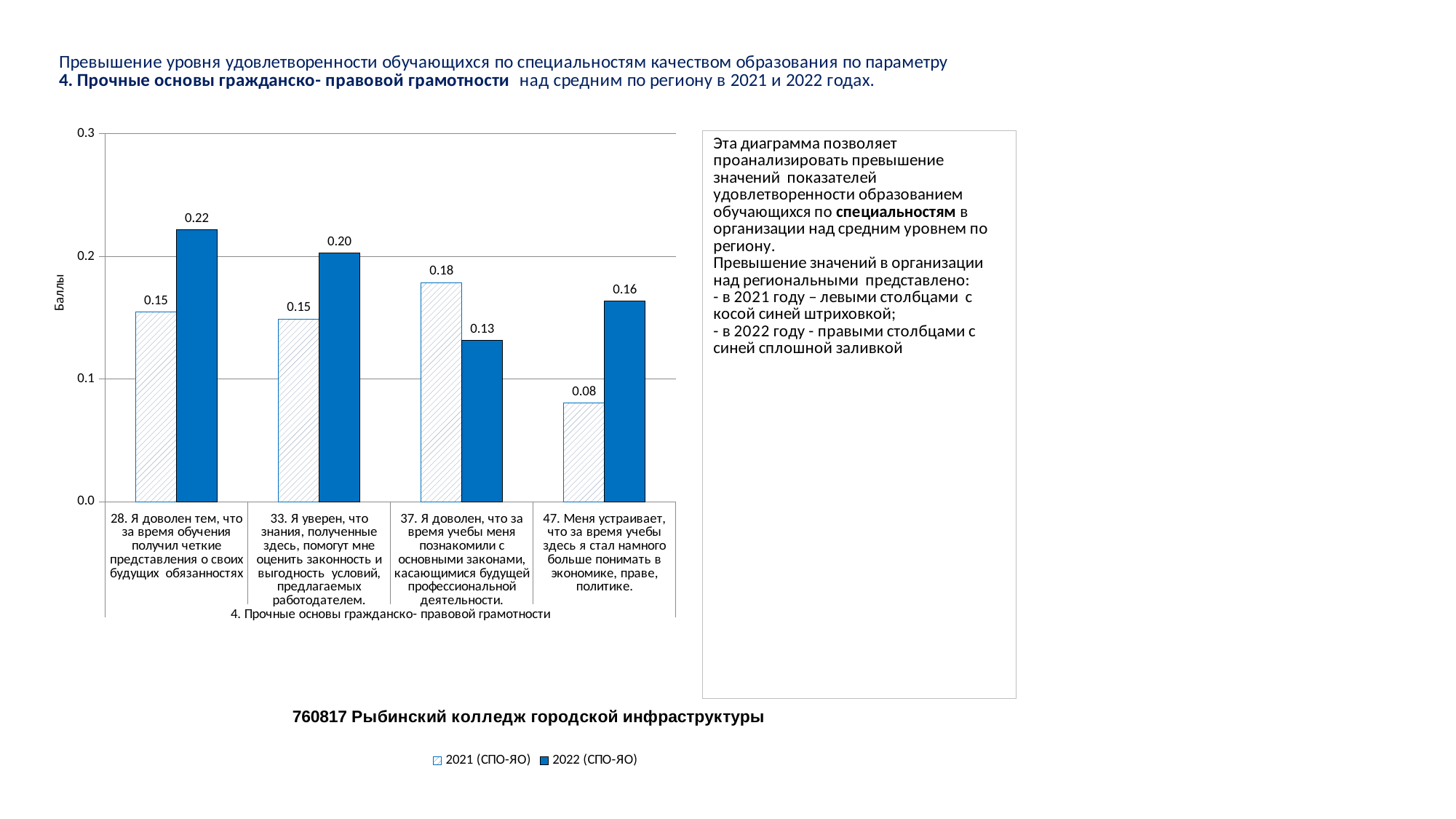
What type of chart is shown on the slide? bar chart How many series does the legend list? 2 Which category has the highest value in the 2022 (СПО-ЯО) series? 28. Я доволен тем, что за время обучения получил четкие представления о своих будущих обязанностях What is the label of the y axis of the chart? Баллы Which category has the lowest value in the 2021 (СПО-ЯО) series? 47. Меня устраивает, что за время учебы здесь я стал намного больше понимать в экономике, праве, политике. How many categories are shown on the x axis of the chart? 4 What is the difference between the 2022 and 2021 values for category 33 ("Я уверен, что знания, полученные здесь, помогут мне оценить законность и выгодность условий, предлагаемых работодателем")? 0.05 Is the 2022 (СПО-ЯО) value for category 47 greater or less than 0.1? greater What is the value of the 2021 (СПО-ЯО) series for category 47 ("Меня устраивает, что за время учебы здесь я стал намного больше понимать в экономике, праве, политике")? 0.08 What is the value of the 2021 (СПО-ЯО) series for category 37 ("Я доволен, что за время учебы меня познакомили с основными законами...")? 0.18 For category 37, which series has the larger value, 2021 (СПО-ЯО) or 2022 (СПО-ЯО)? 2021 (СПО-ЯО) What is the value of the 2022 (СПО-ЯО) series for category 28 ("Я доволен тем, что за время обучения получил четкие представления о своих будущих обязанностях")? 0.22